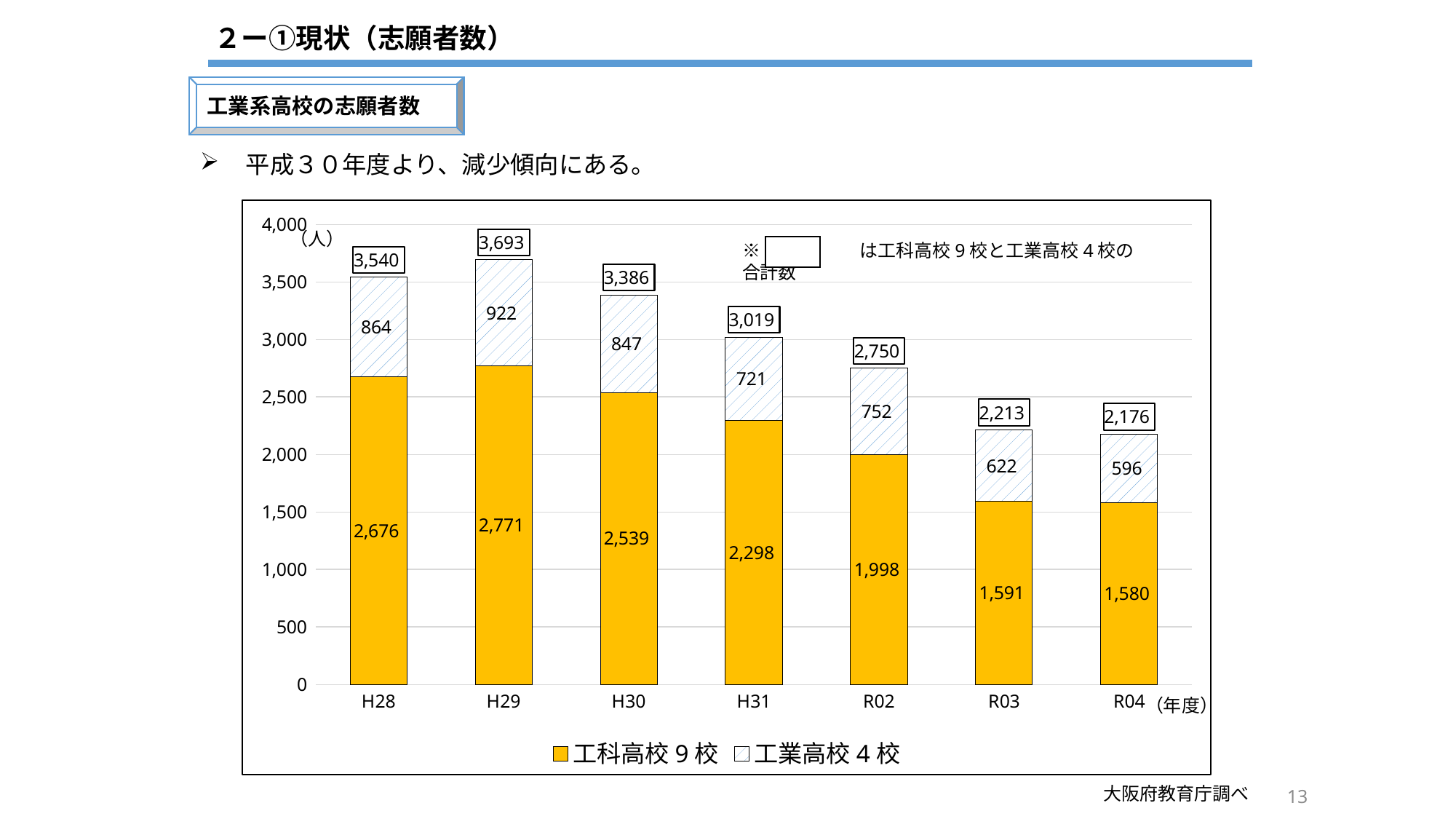
What is the value for 工科高校９校 in H29? 2,771 What is the total of the stacked bar for H30? 3,386 How many series does the legend list? 2 What is the difference between the 工業高校４校 values for H29 and H31? 201 Which year has the highest total number of applicants? H29 How many years are shown on the x axis? 7 Which is larger: the 工科高校９校 value in H28 or in H30? H28 Is the total for R02 greater or less than 3,000? less Which year has the lowest value for 工科高校９校? R04 Do the total values rise or fall from H29 to R04? fall What is the value for 工業高校４校 in R04? 596 What kind of chart is shown? stacked bar chart